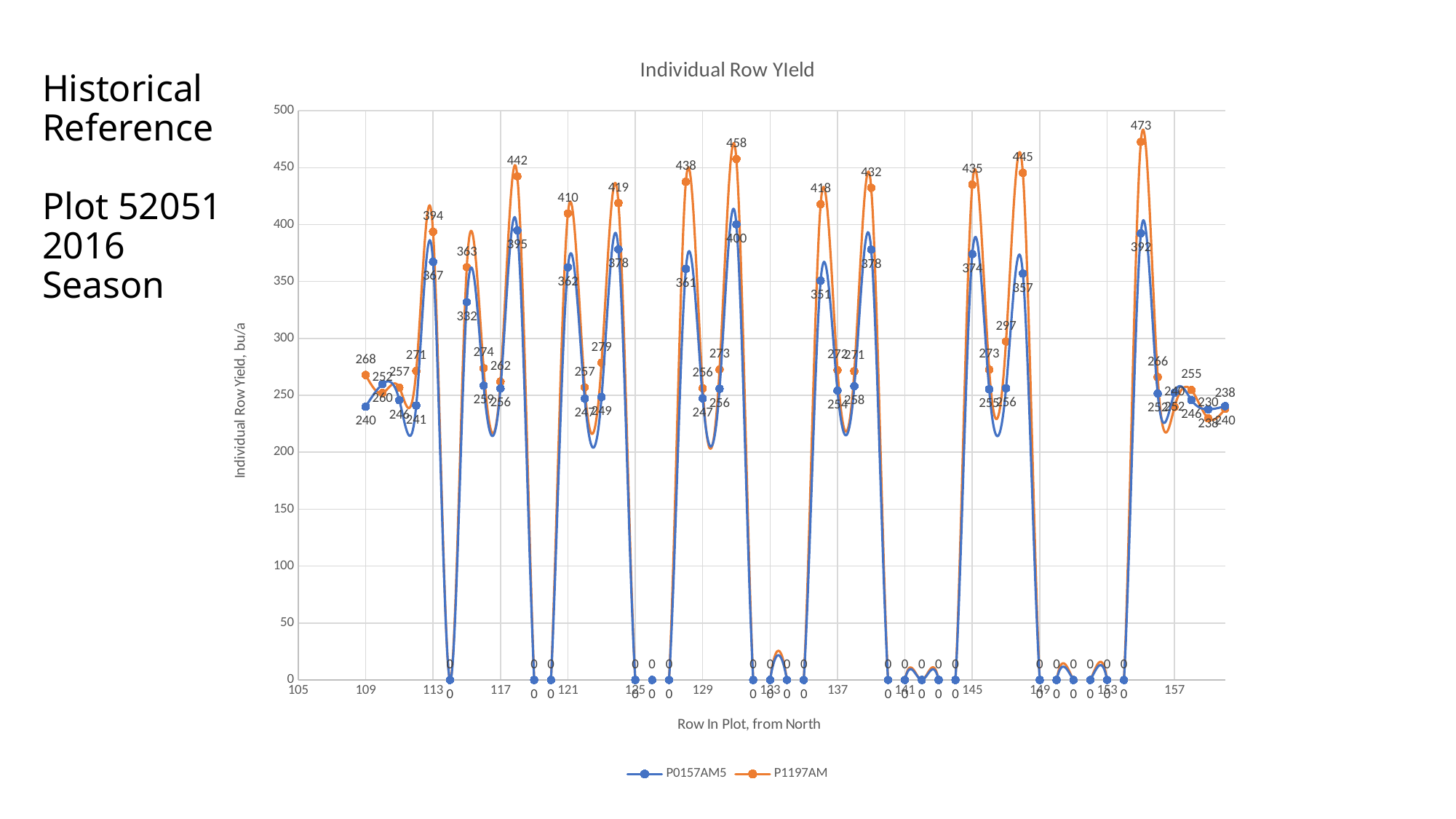
How many series does the legend list? 2 At the peak labelled 473 for P1197AM, what is the corresponding labelled value for P0157AM5? 392 What is the difference between the labelled peaks 458 (P1197AM) and 400 (P0157AM5)? 58 Is the highest value of the P1197AM series greater or less than 450? greater What is the labelled value of the P1197AM series at row 109? 268 What is the title of the chart? Individual Row YIeld At the peak where P1197AM is labelled 442 and P0157AM5 is labelled 395, which series is higher? P1197AM What are the two series named in the legend? P0157AM5 and P1197AM What is the highest labelled value for the P1197AM series? 473 What kind of chart is shown on the slide? line chart What is the difference between the P1197AM peak of 473 and the P0157AM5 peak of 392 at the same row? 81 What is the highest labelled value for the P0157AM5 series? 400